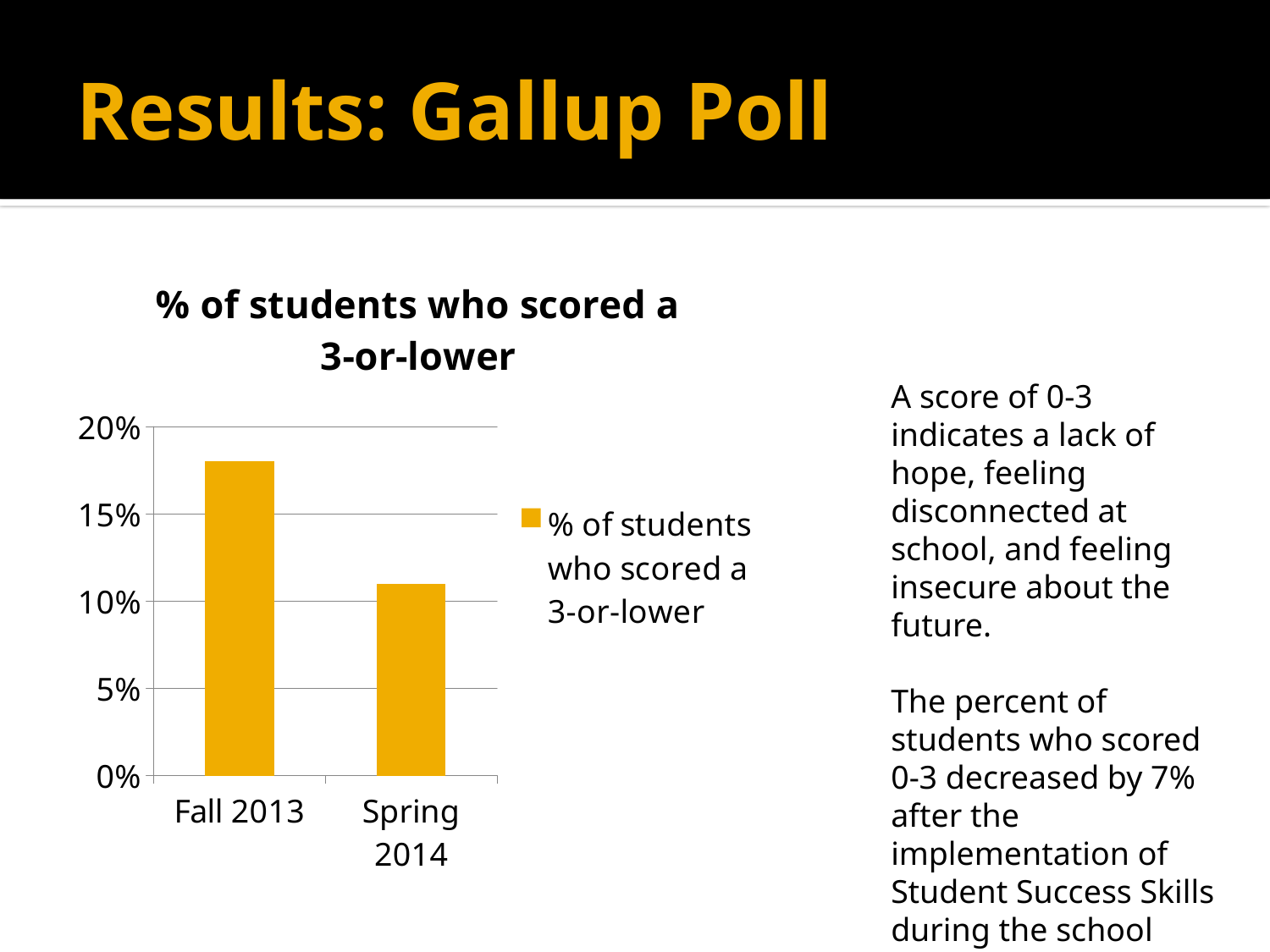
Which is larger, the value for Fall 2013 or the value for Spring 2014? Fall 2013 How many series does the chart legend list? 1 What kind of chart is shown on the slide? bar chart How many categories are shown on the x axis of the chart? 2 What colour are the bars in the chart? yellow Is the value for Fall 2013 greater or less than 20%? less Which category has the lowest value in the chart? Spring 2014 Is the value for Fall 2013 greater or less than 15%? greater Which category has the highest value in the chart? Fall 2013 Do the values rise or fall from Fall 2013 to Spring 2014? fall What is the title of the chart? % of students who scored a 3-or-lower Is the value for Spring 2014 greater or less than 15%? less